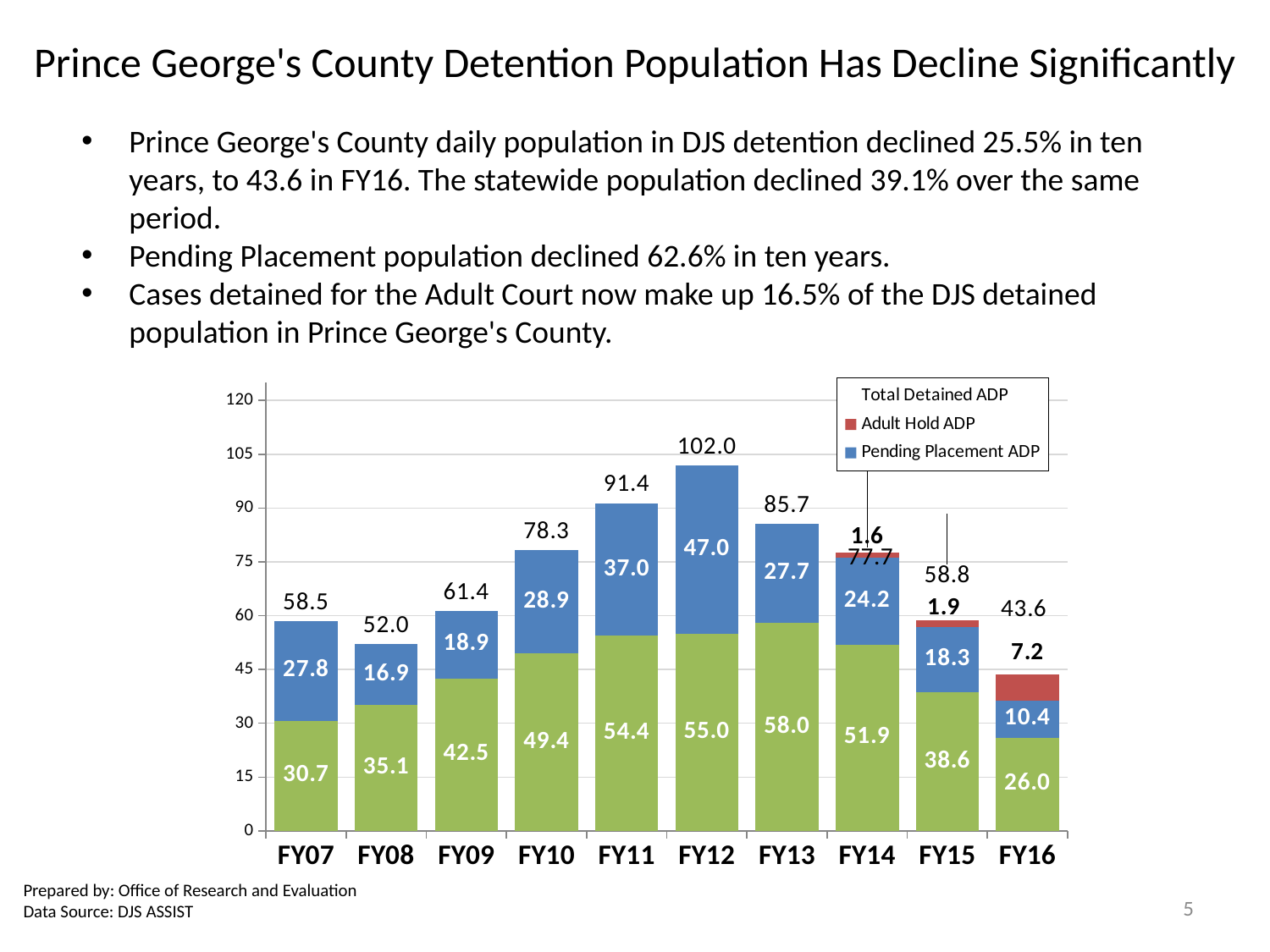
How many entries does the chart's legend list? 3 What is the Pending Placement ADP for FY11? 37.0 Which fiscal year has the highest Total Detained ADP? FY12 Which is larger, the Pending Placement ADP in FY10 or in FY14? FY10 What is the difference between the Total Detained ADP in FY12 and in FY07? 43.5 What is the Adult Hold ADP for FY16? 7.2 How many fiscal years are shown on the x axis of the chart? 10 From FY12 to FY16, does the Total Detained ADP rise or fall? Fall What is the Total Detained ADP for FY09? 61.4 Is the Total Detained ADP for FY13 greater or less than 90? less Which fiscal year has the lowest Total Detained ADP? FY16 What kind of chart is shown on the slide? Stacked bar chart